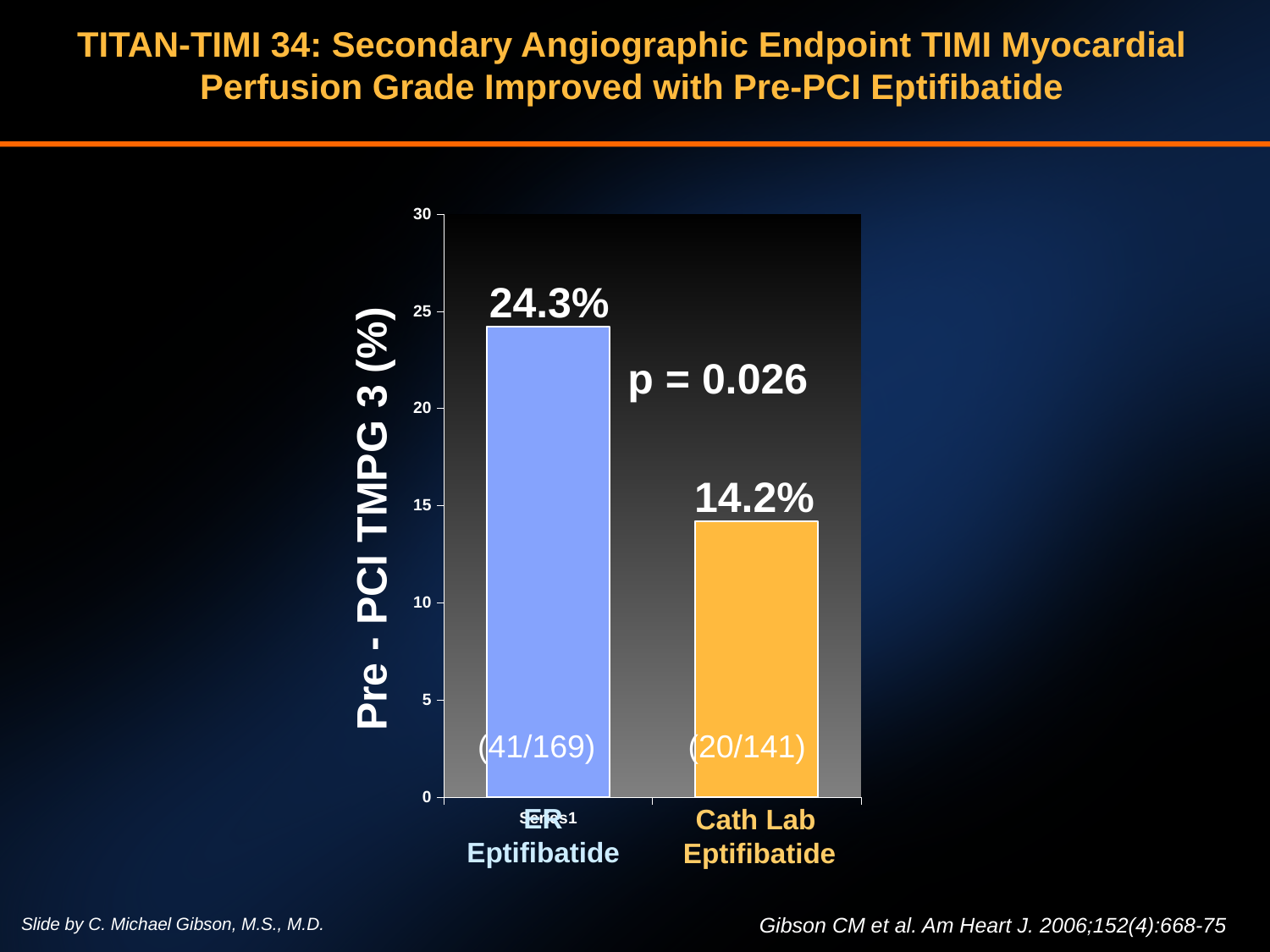
Is the value for ER Eptifibatide greater or less than 20? greater What is the label of the y-axis? Pre - PCI TMPG 3 (%) How many groups are plotted in the chart? 2 What is the Pre-PCI TMPG 3 value for Cath Lab Eptifibatide? 14.2% What is the Pre-PCI TMPG 3 value for ER Eptifibatide? 24.3% What fraction is shown inside the ER Eptifibatide bar? (41/169) Which group has the lower Pre-PCI TMPG 3 rate? Cath Lab Eptifibatide What is the difference in Pre-PCI TMPG 3 rate between ER Eptifibatide and Cath Lab Eptifibatide? 10.1% What is the p-value shown on the chart? p = 0.026 Which group has the higher Pre-PCI TMPG 3 rate? ER Eptifibatide Is the value for Cath Lab Eptifibatide greater or less than 15? less What kind of chart is shown on the slide? Bar chart